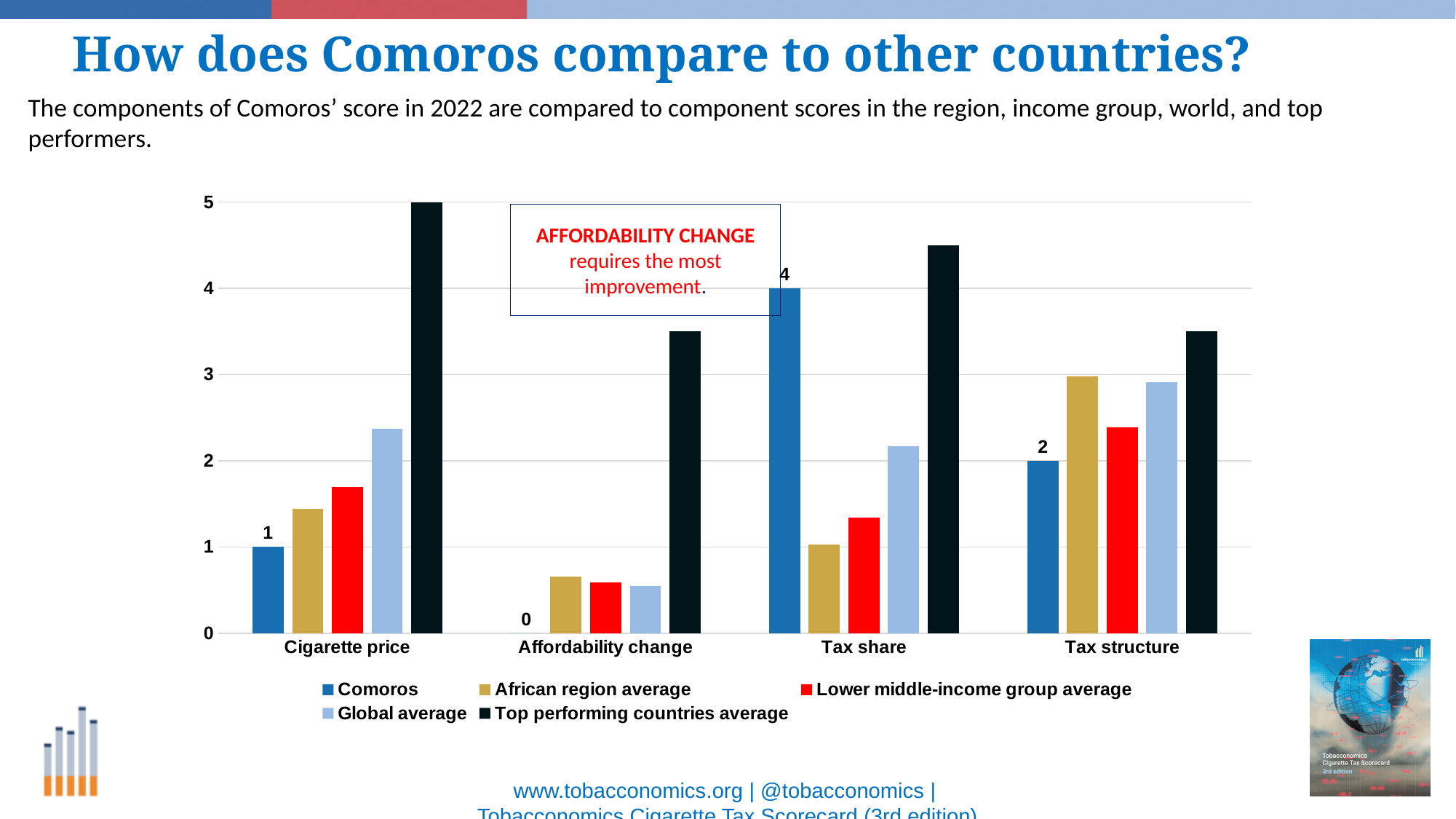
In which component does Comoros have its highest score? Tax share For Tax structure, which is larger: the Comoros score or the African region average? African region average What is the Comoros score for Affordability change? 0 What is the Comoros score for Cigarette price? 1 What is the Comoros score for Tax share? 4 Is the Top performing countries average for Tax share greater or less than 4? greater What kind of chart is shown on the slide? bar chart What is the difference between the Comoros scores for Tax share and Cigarette price? 3 In which component does Comoros have its lowest score? Affordability change What is the Comoros score for Tax structure? 2 How many components (categories) are shown on the x axis? 4 How many series does the legend list? 5